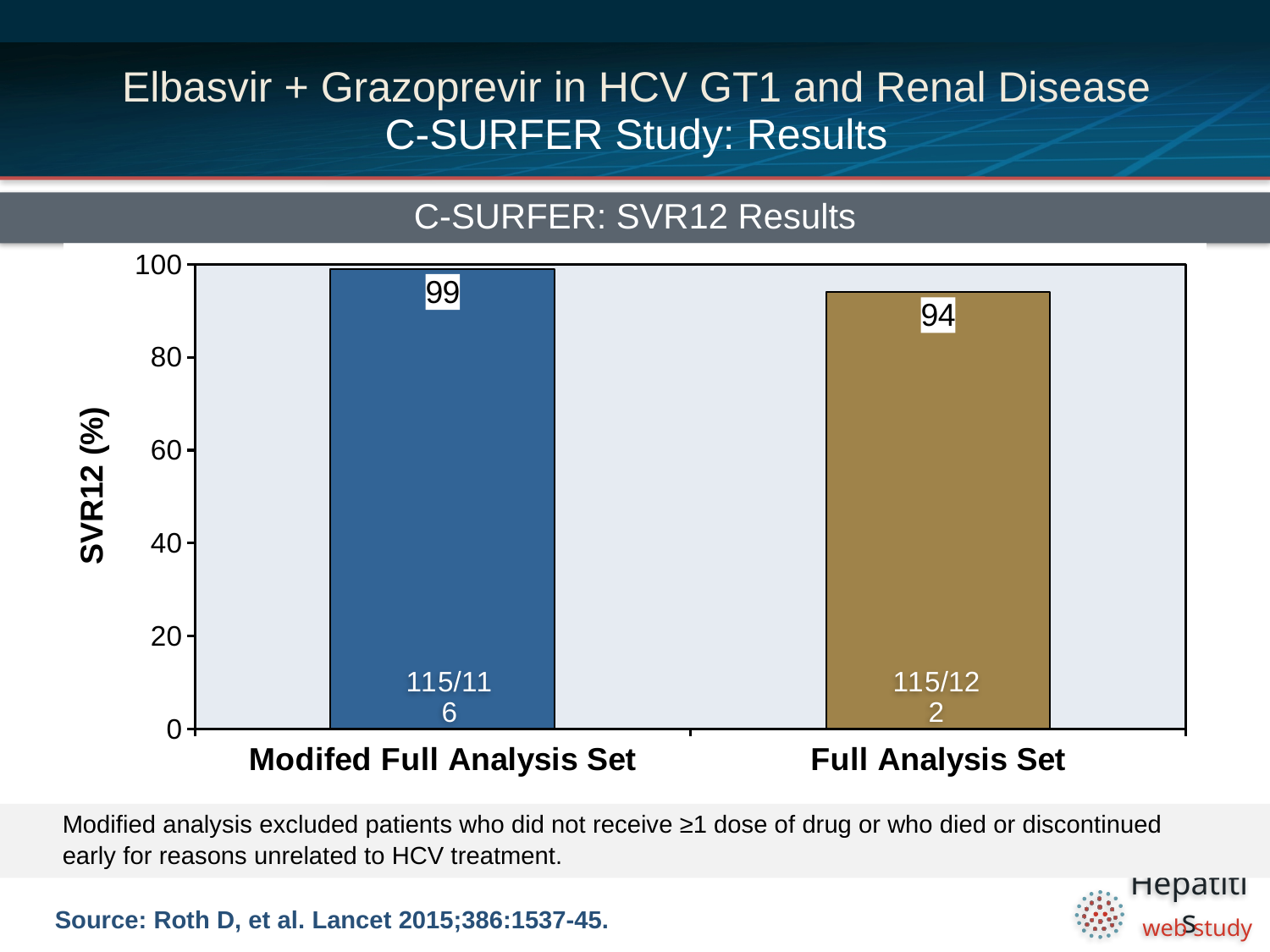
Which analysis set has the higher SVR12 (%)? Modifed Full Analysis Set What is the SVR12 (%) value for the Full Analysis Set? 94 What is the label of the y axis? SVR12 (%) What is the difference in SVR12 (%) between the Modifed Full Analysis Set and the Full Analysis Set? 5 What is the title of the chart? C-SURFER: SVR12 Results What fraction of patients is printed inside the bar for the Modifed Full Analysis Set? 115/116 Which analysis set has the lower SVR12 (%)? Full Analysis Set Is the SVR12 (%) for the Full Analysis Set greater or less than 80? greater What fraction of patients is printed inside the bar for the Full Analysis Set? 115/122 What is the SVR12 (%) value for the Modifed Full Analysis Set? 99 How many categories are shown on the x axis of the chart? 2 What kind of chart is shown on the slide? Bar chart